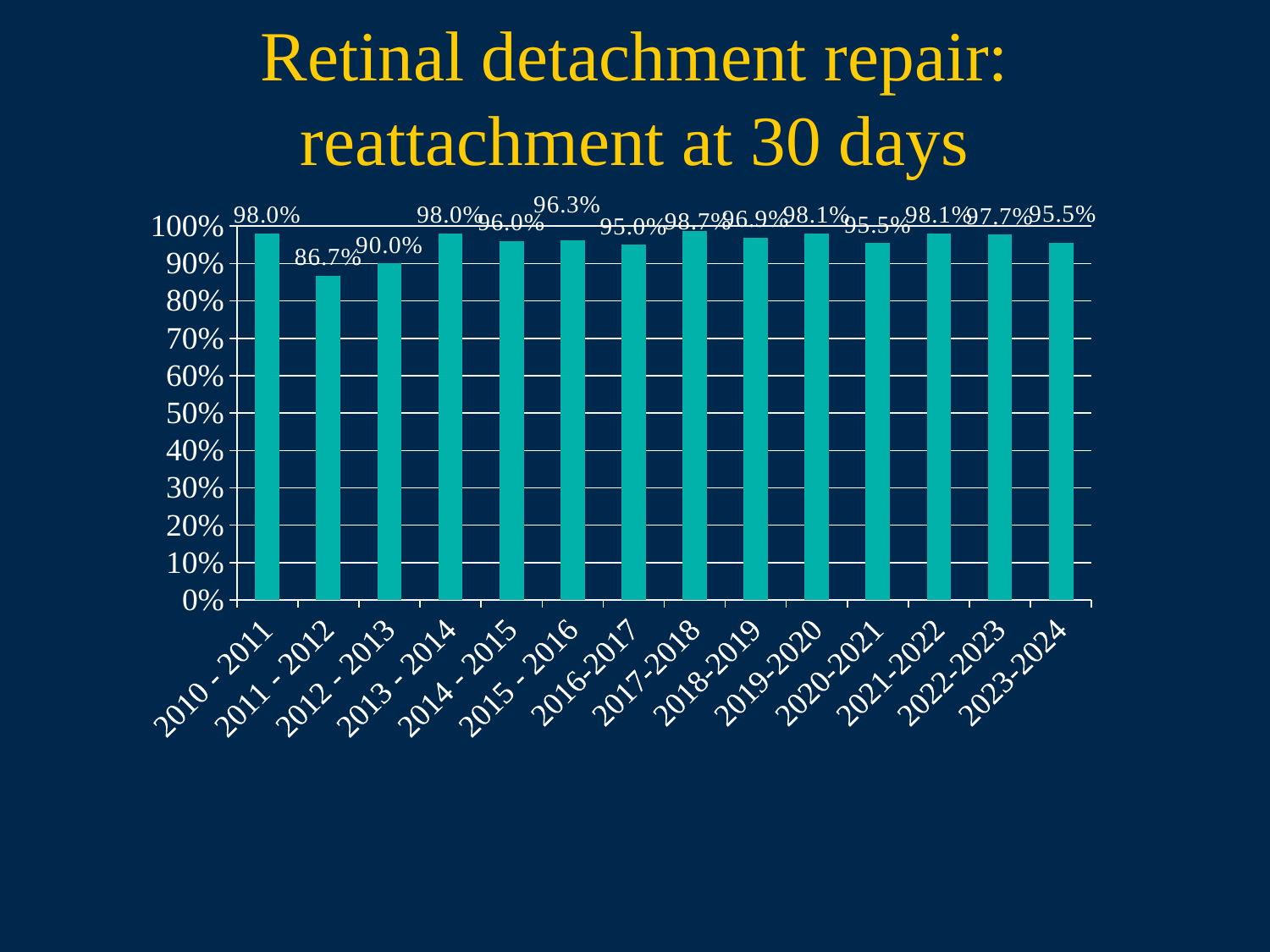
What is the reattachment rate for 2010 - 2011? 98.0% What is the difference between the reattachment rates for 2010 - 2011 and 2011 - 2012? 11.3% What is the reattachment rate for 2011 - 2012? 86.7% What is the reattachment rate for 2023-2024? 95.5% Which year has the lowest reattachment rate? 2011 - 2012 How many year periods are shown on the chart? 14 What is the reattachment rate for 2012 - 2013? 90.0% Is the reattachment rate for 2011 - 2012 greater or less than 90%? less Which is larger, the reattachment rate for 2012 - 2013 or for 2013 - 2014? 2013 - 2014 Which year has the highest reattachment rate? 2017-2018 What kind of chart is shown on the slide? bar chart What is the title of the chart? Retinal detachment repair: reattachment at 30 days